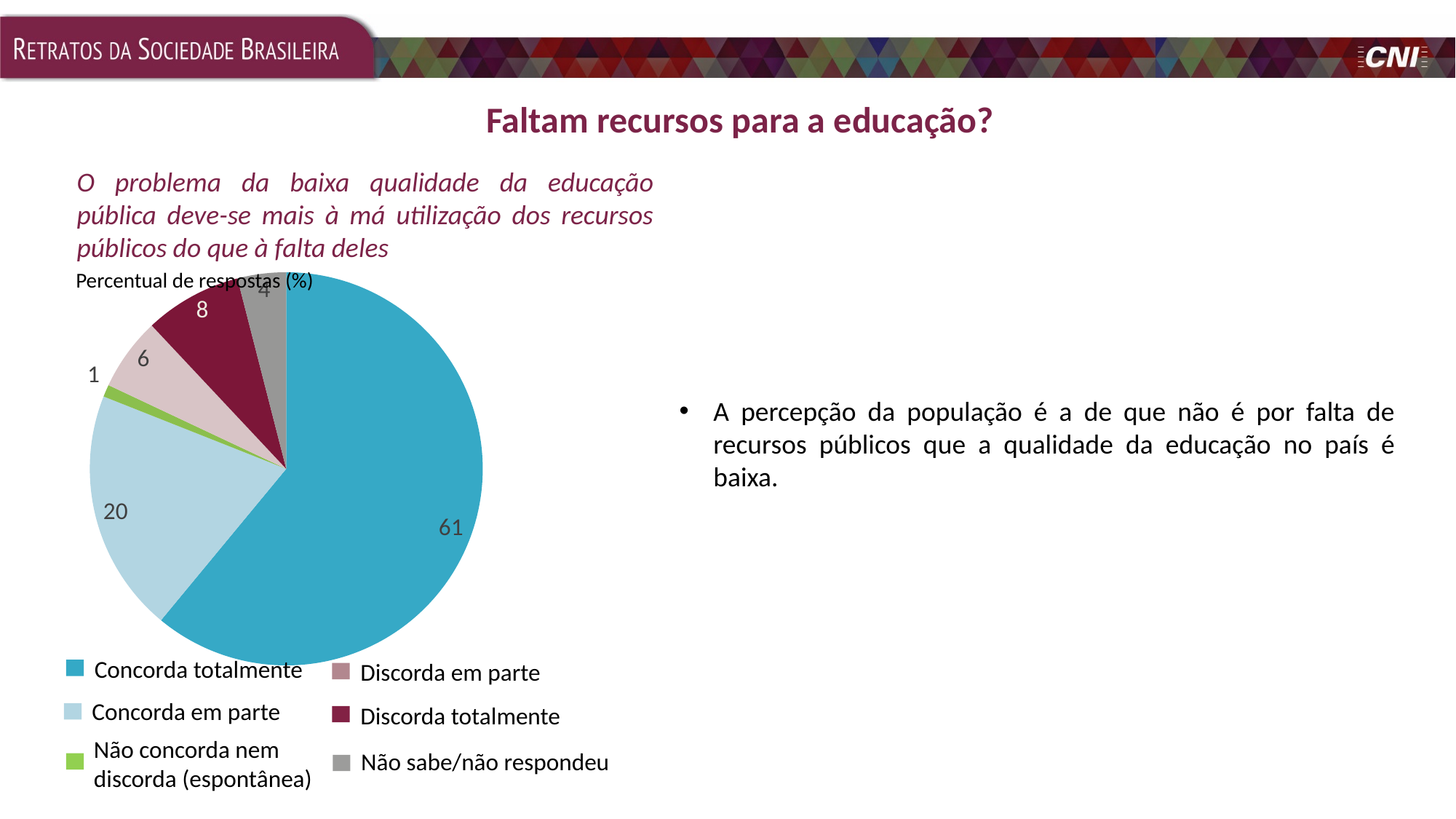
What is the difference in percentage points between "Concorda totalmente" and "Concorda em parte"? 41 Which response category has the largest share of the pie? Concorda totalmente Which response category has the smallest share of the pie? Não concorda nem discorda (espontânea) What percentage of respondents answered "Discorda em parte"? 6 What percentage of respondents answered "Concorda totalmente"? 61 What colour is the slice for "Não concorda nem discorda (espontânea)"? Green What kind of chart is shown on the slide? Pie chart What percentage of respondents answered "Não sabe/não respondeu"? 4 What percentage of respondents answered "Concorda em parte"? 20 What percentage of respondents answered "Discorda totalmente"? 8 How many response categories does the pie chart show? 6 Which is larger, the share for "Discorda totalmente" or the share for "Discorda em parte"? Discorda totalmente